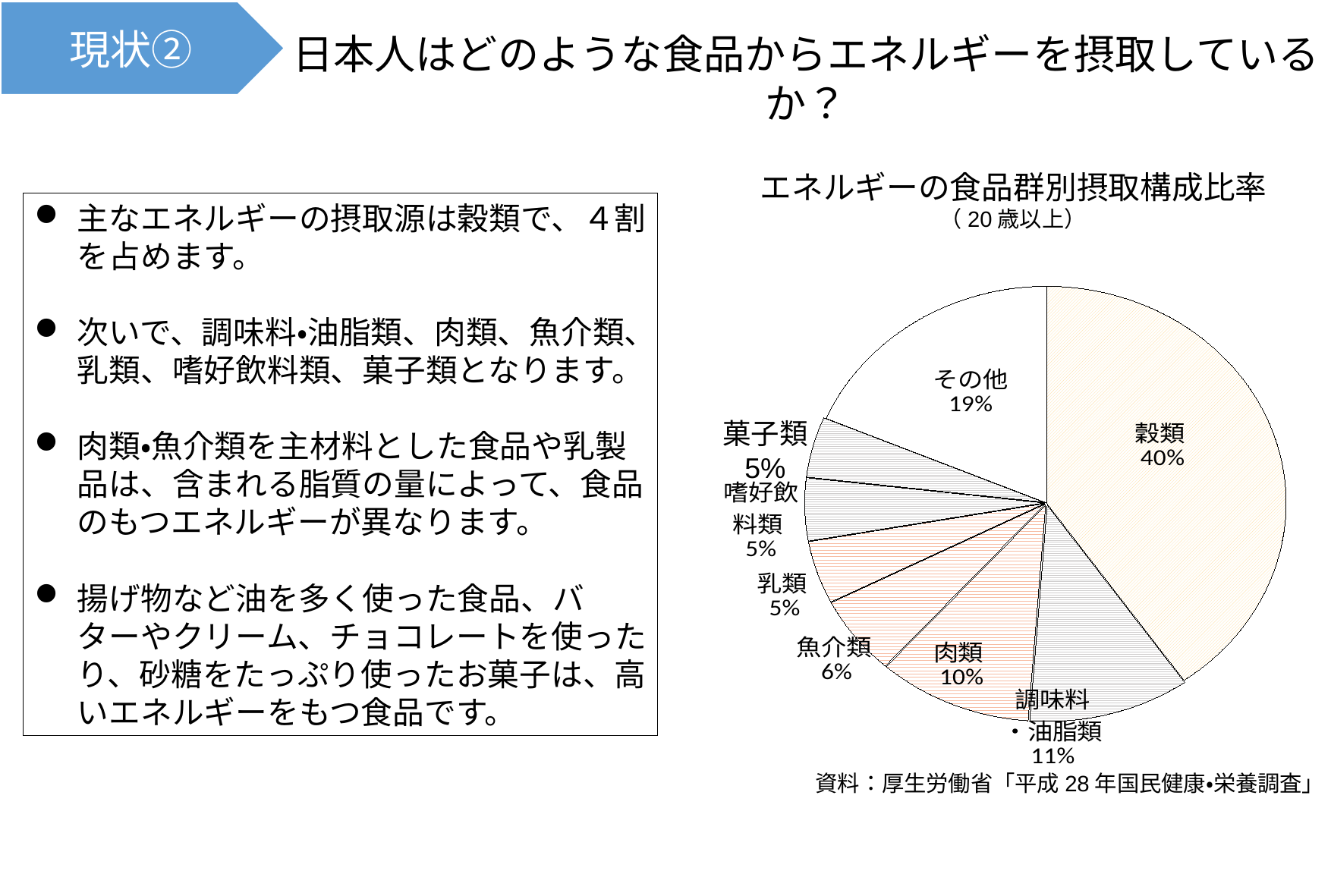
What share of energy intake comes from 魚介類? 6% What share of energy intake comes from 調味料・油脂類? 11% What is the combined share of 乳類, 嗜好飲料類 and 菓子類? 15% Which food group has the largest slice of the pie? 穀類 How many slices does the pie chart have? 8 Which is larger, the share for 肉類 or the share for 魚介類? 肉類 What share of energy intake comes from 肉類? 10% What is the difference in percentage points between 穀類 and その他? 21 What is the title of the chart? エネルギーの食品群別摂取構成比率（20歳以上） What kind of chart is shown on the slide? pie chart